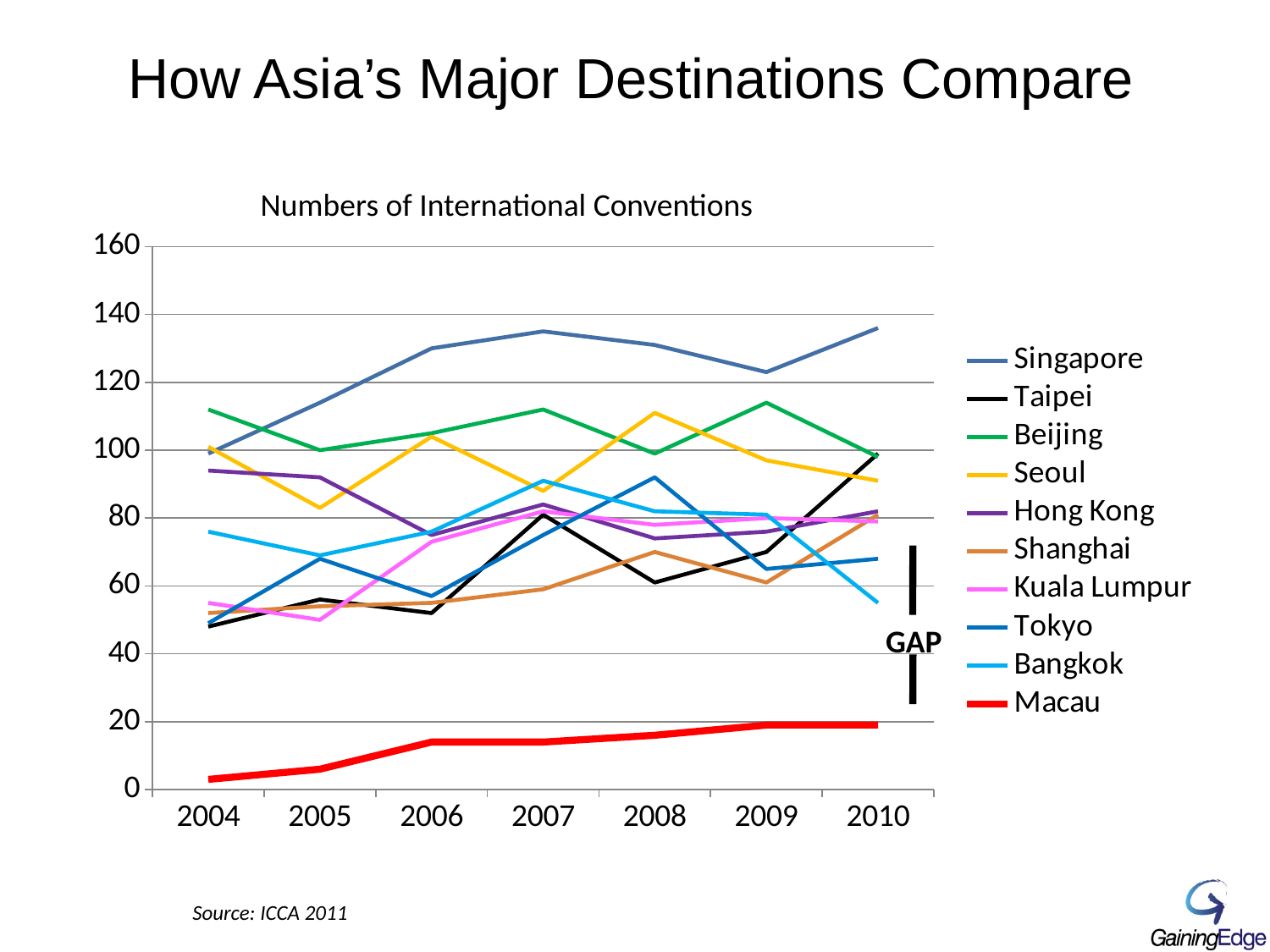
Which destination has the lowest number of international conventions in 2010? Macau How many series does the legend list? 10 Is the value for Macau in 2010 greater or less than 40? less Which destination has the highest number of international conventions in 2010? Singapore What type of chart is shown on the slide? Line chart In 2005, which had more international conventions, Beijing or Seoul? Beijing Is the value for Singapore in 2010 greater or less than 120? greater Which destination is drawn with the thick red line? Macau Does the Macau line rise or fall from 2004 to 2010? Rises How many years are shown along the x axis? 7 What is the title of the chart? Numbers of International Conventions Is the value for Beijing in 2009 greater or less than 100? greater